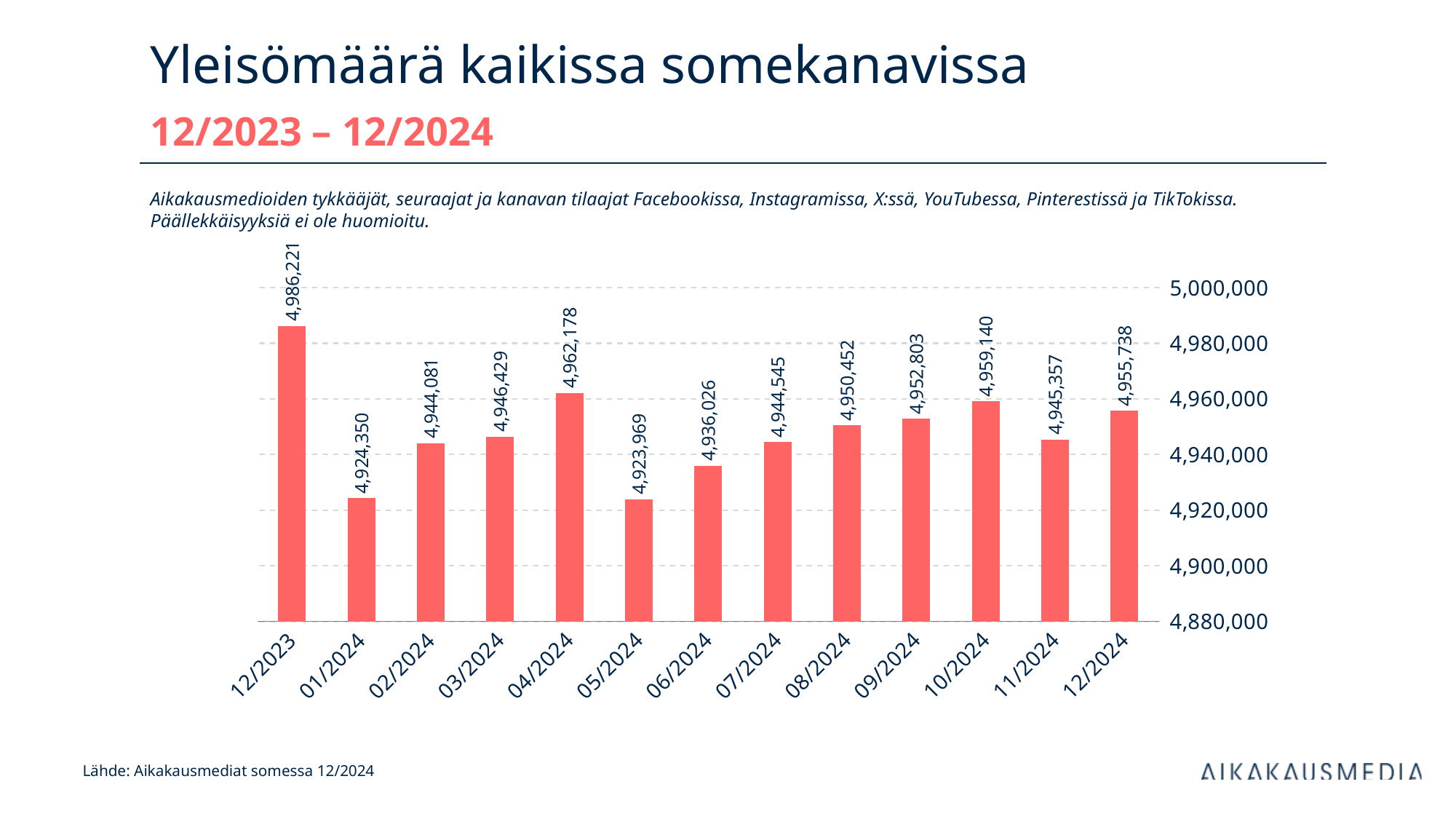
What is the difference between the values for 12/2023 and 12/2024? 30,483 What is the value for 05/2024? 4,923,969 What is the title of the chart on the slide? Yleisömäärä kaikissa somekanavissa What is the value for 12/2024? 4,955,738 What is the difference between the values for 04/2024 and 03/2024? 15,749 Is the value for 06/2024 greater or less than 4,940,000? less What kind of chart is shown on the slide? bar chart What is the value for 12/2023? 4,986,221 Which is larger, the value for 10/2024 or the value for 11/2024? 10/2024 How many months are shown on the x axis? 13 Which month has the lowest value? 05/2024 Which month has the highest value? 12/2023